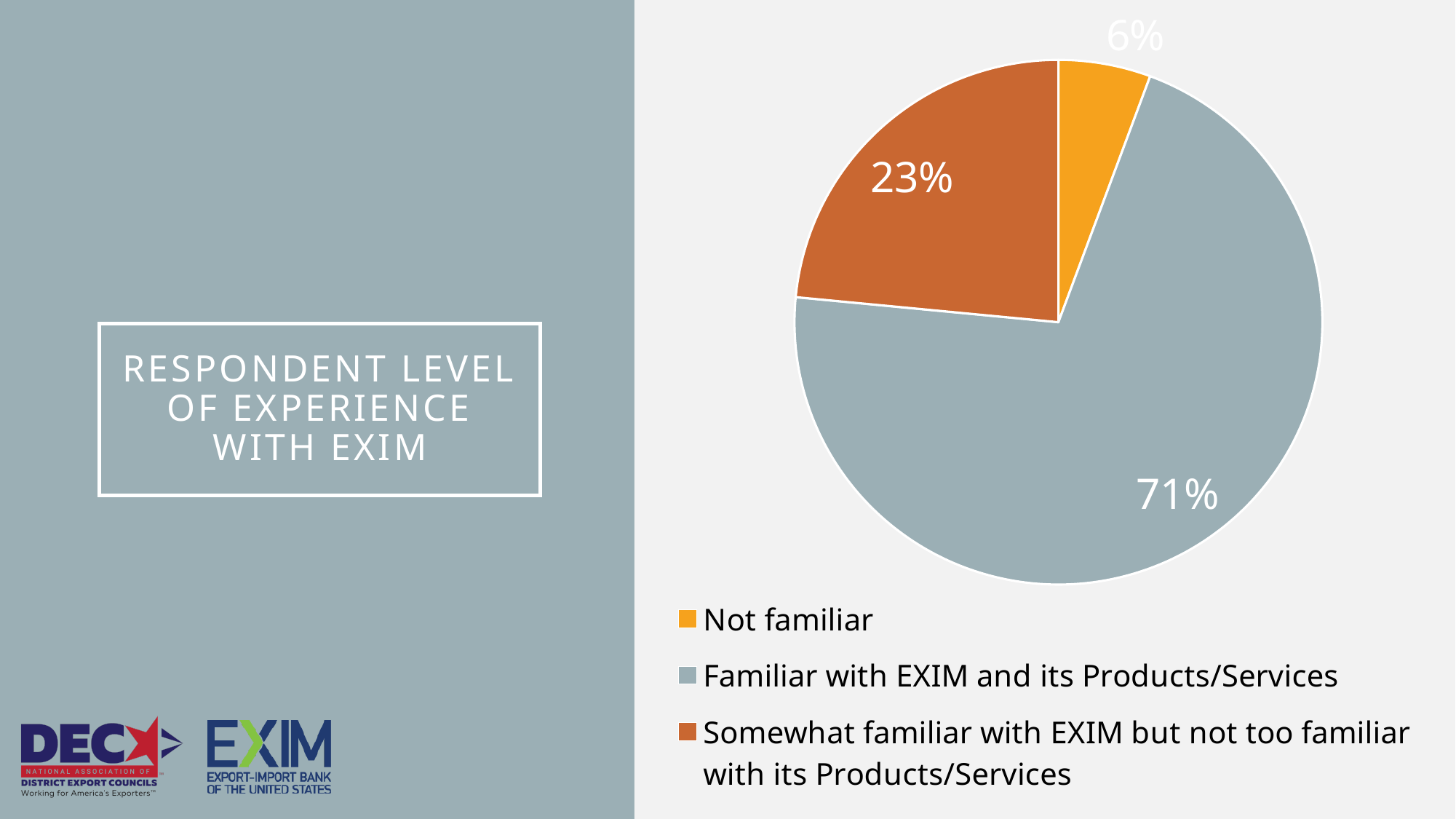
What is the title shown in the box on the left of the slide? Respondent Level of Experience with EXIM How many categories does the pie chart have? 3 What percentage of respondents are familiar with EXIM and its Products/Services? 71% What colour is the 'Not familiar' slice? Yellow/orange Which category has the largest share of the pie? Familiar with EXIM and its Products/Services Which category has the smallest share of the pie? Not familiar What kind of chart is shown on the slide? Pie chart What is the difference in percentage points between the 'Familiar with EXIM and its Products/Services' slice and the 'Somewhat familiar' slice? 48 How many entries does the legend list? 3 What percentage of respondents are somewhat familiar with EXIM but not too familiar with its Products/Services? 23% What percentage of respondents are not familiar with EXIM? 6% Which is larger: the 'Not familiar' slice or the 'Somewhat familiar with EXIM but not too familiar with its Products/Services' slice? Somewhat familiar with EXIM but not too familiar with its Products/Services